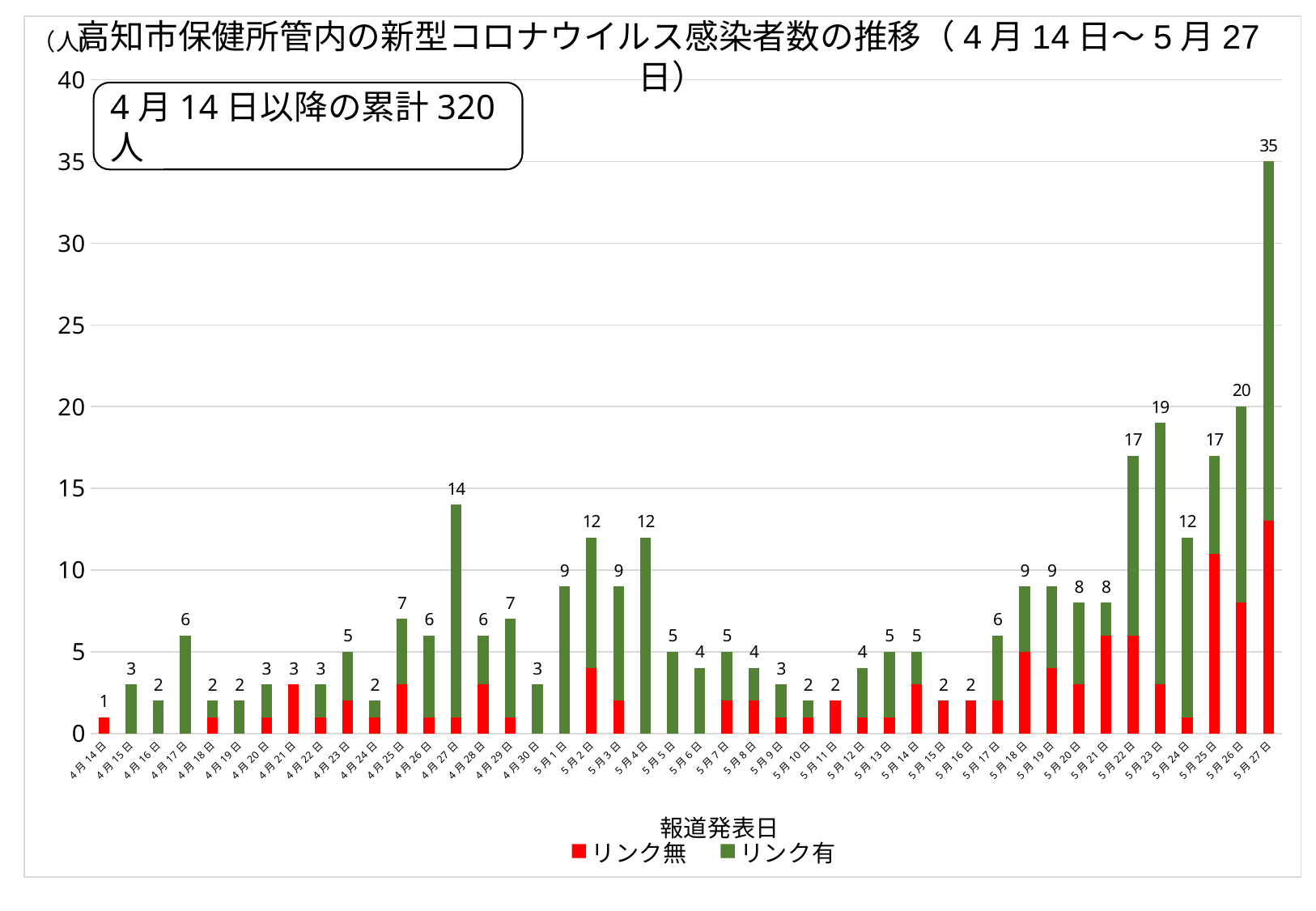
Which date has a larger total, 4月27日 or 5月2日? 4月27日 Which date has the highest total number of cases? 5月27日 What kind of chart is this? Stacked bar chart How many dates are shown on the x axis? 44 How many series does the legend list? 2 What is the total value for 4月27日? 14 What are the two legend entries? リンク無, リンク有 What cumulative total is stated in the box on the chart? 320人 Is the リンク無 value for 5月25日 greater or less than 10? greater What is the difference between the totals for 5月27日 and 5月26日? 15 Which date has the lowest total number of cases? 4月14日 What is the total value for 5月27日? 35